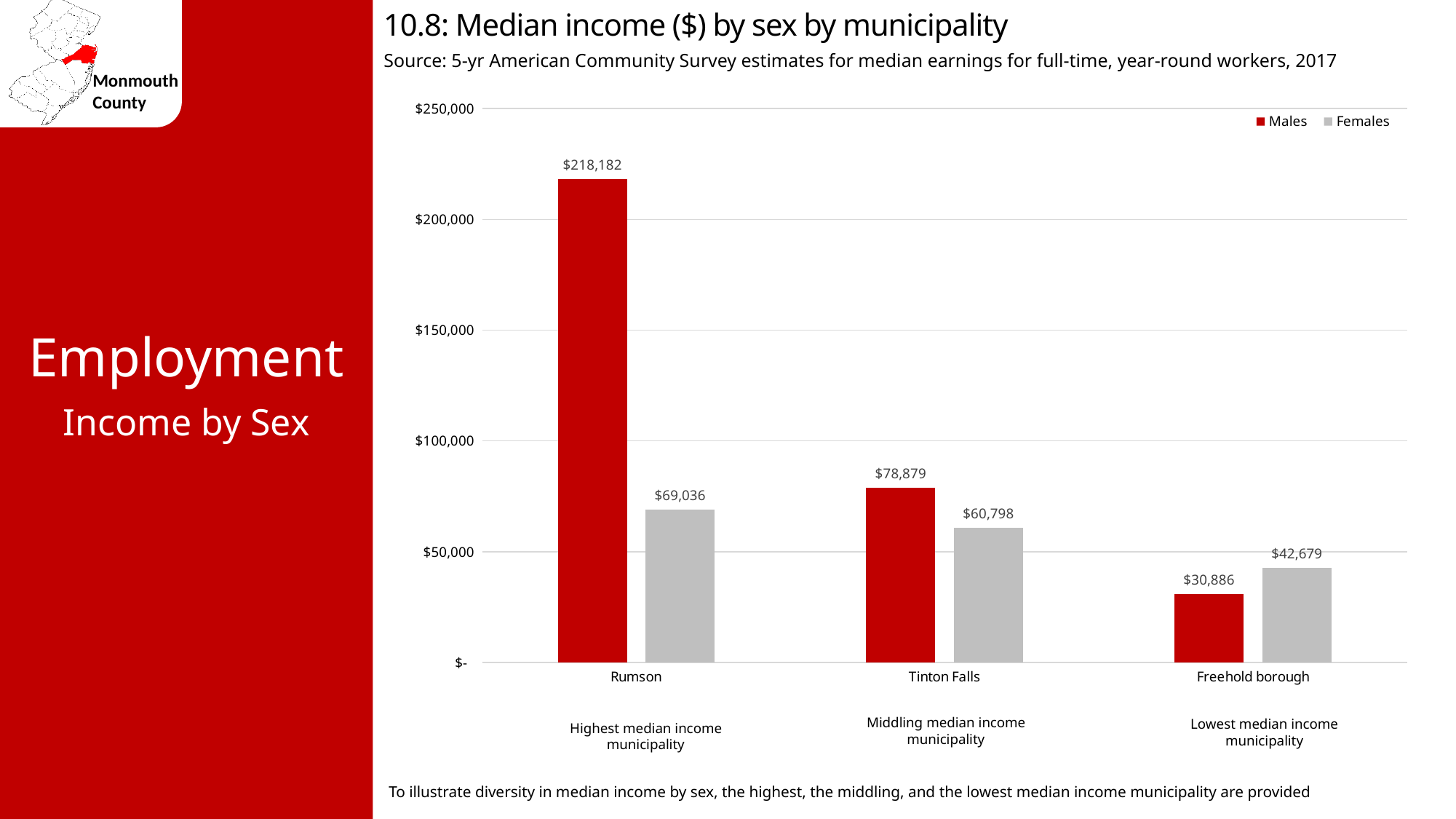
What is the difference between male and female median income in Rumson? $149,146 What is the median income for males in Rumson? $218,182 In Freehold borough, which is larger: the median income for males or for females? Females How many municipalities are shown on the chart? 3 What is the difference between male and female median income in Tinton Falls? $18,081 What kind of chart is shown on the slide? Bar chart What is the median income for males in Freehold borough? $30,886 Which municipality has the lowest median income for females? Freehold borough Which municipality has the highest median income for males? Rumson Is the median income for females in Rumson greater or less than $50,000? greater How many series does the legend list? 2 What is the median income for females in Tinton Falls? $60,798